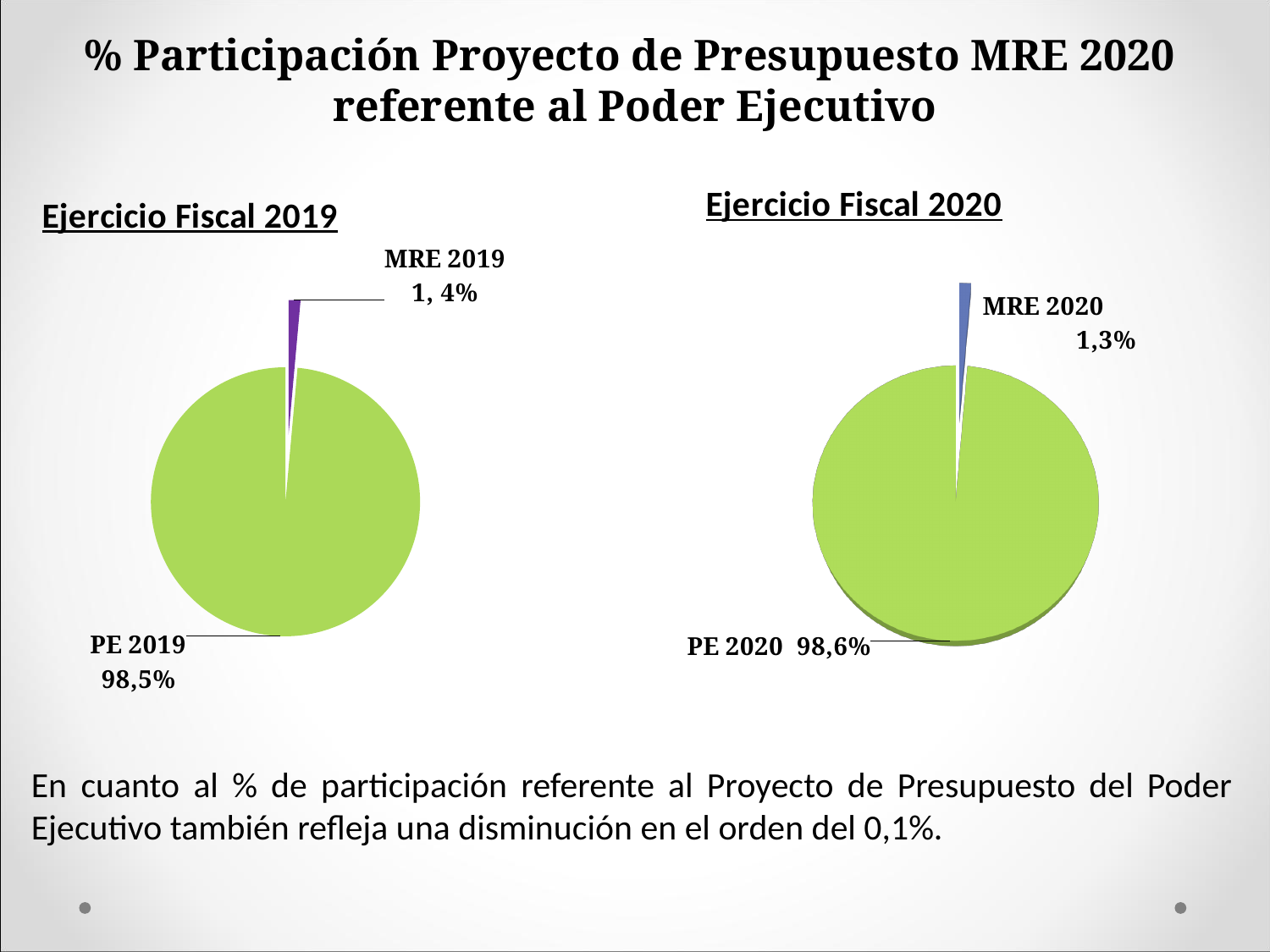
How many slices does the Ejercicio Fiscal 2019 pie chart have? 2 In the Ejercicio Fiscal 2020 pie chart, what is the difference between the PE 2020 and MRE 2020 percentages? 97,3% What type of chart is used for Ejercicio Fiscal 2020? Pie chart In the Ejercicio Fiscal 2020 pie chart, what percentage is shown for MRE 2020? 1,3% In the Ejercicio Fiscal 2019 pie chart, what percentage is shown for PE 2019? 98,5% In the Ejercicio Fiscal 2019 pie chart, which slice is the largest? PE 2019 In the Ejercicio Fiscal 2020 pie chart, which slice is the smallest? MRE 2020 What is the title of the slide containing the two pie charts? % Participación Proyecto de Presupuesto MRE 2020 referente al Poder Ejecutivo In the Ejercicio Fiscal 2019 pie chart, what percentage is shown for MRE 2019? 1, 4% Which is larger: the MRE 2019 share in the Ejercicio Fiscal 2019 chart or the MRE 2020 share in the Ejercicio Fiscal 2020 chart? MRE 2019 What share of the Ejercicio Fiscal 2020 pie does PE 2020 represent? 98,6% In the Ejercicio Fiscal 2020 pie chart, what percentage is shown for PE 2020? 98,6%